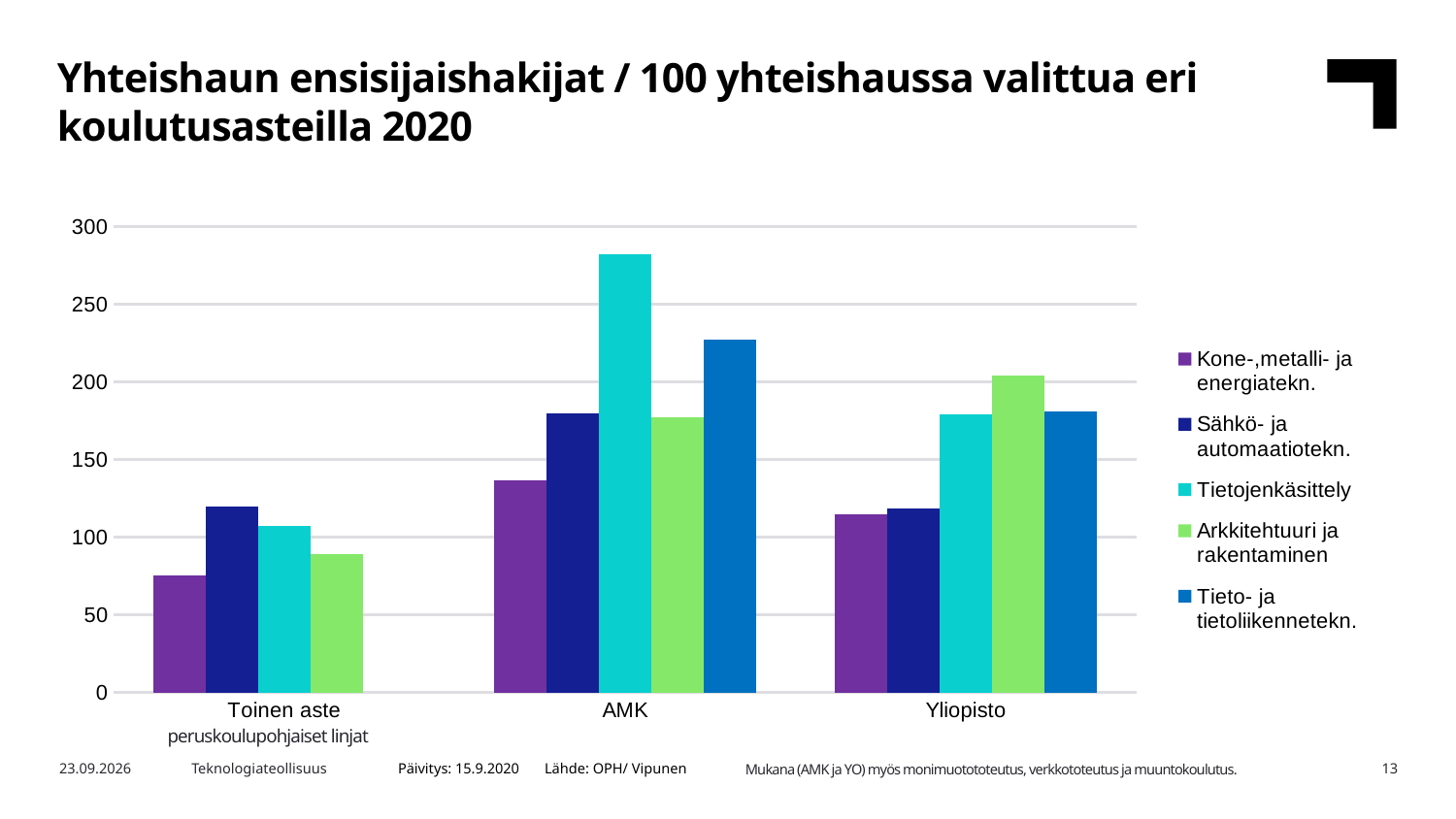
Is the value for Tieto- ja tietoliikennetekn. in the AMK category greater or less than 200? greater Is the value for Tietojenkäsittely in the AMK category greater or less than 250? greater For Arkkitehtuuri ja rakentaminen, which category has the larger value: AMK or Yliopisto? Yliopisto Which legend series has no bar in the Toinen aste category? Tieto- ja tietoliikennetekn. How many series does the legend list? 5 Which series has the lowest value in the AMK category? Kone-,metalli- ja energiatekn. Which series has the highest value in the Yliopisto category? Arkkitehtuuri ja rakentaminen In the Toinen aste category, which is larger: Sähkö- ja automaatiotekn. or Tietojenkäsittely? Sähkö- ja automaatiotekn. Is the value for Kone-,metalli- ja energiatekn. in the Toinen aste category greater or less than 100? less Which series has the tallest bar in the whole chart, and in which category? Tietojenkäsittely, AMK How many education-level categories are shown on the x axis? 3 What kind of chart is shown on the slide? bar chart